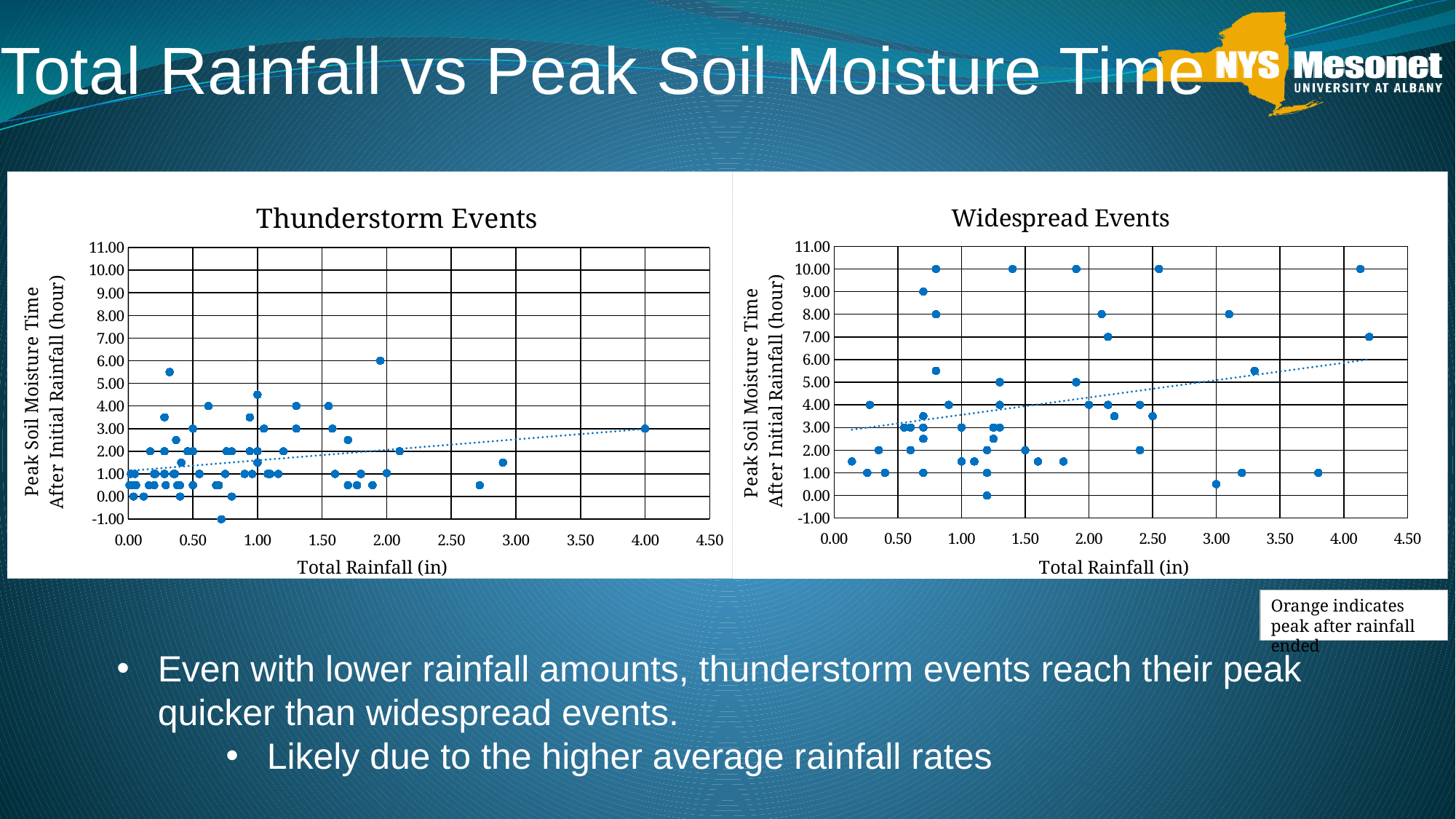
In the Thunderstorm Events chart, what is the x-axis title? Total Rainfall (in) In the Thunderstorm Events chart, what is the lowest peak soil moisture time plotted? -1.00 In the Widespread Events chart, is the peak soil moisture time for the rightmost point (about 4.20 in) greater or less than 5.00? greater In the Widespread Events chart, what is the lowest peak soil moisture time plotted? 0.00 In the Widespread Events chart, does the dotted trend line rise or fall as total rainfall increases? Rise In the Thunderstorm Events chart, does the dotted trend line rise or fall as total rainfall increases? Rise In the Thunderstorm Events chart, what is the peak soil moisture time for the point at 4.00 in of total rainfall? 3.00 In the Thunderstorm Events chart, what is the highest peak soil moisture time plotted? 6.00 Which chart has the higher maximum peak soil moisture time, Thunderstorm Events or Widespread Events? Widespread Events What kind of chart is the Thunderstorm Events chart? Scatter chart In the Widespread Events chart, what is the highest peak soil moisture time plotted? 10.00 In the Widespread Events chart, what is the y-axis title? Peak Soil Moisture Time After Initial Rainfall (hour)